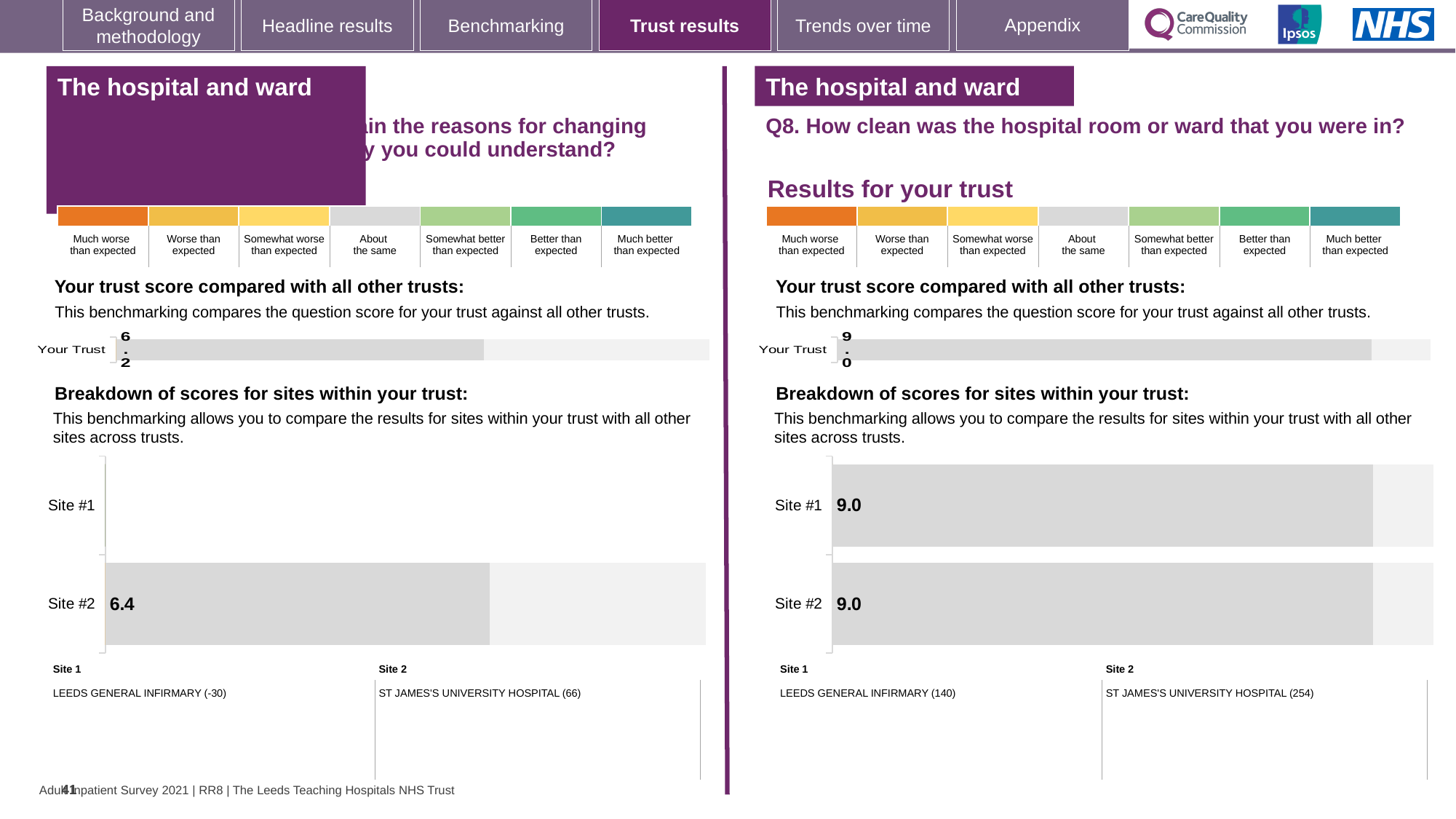
On the right half of the slide (Q8), what is the score for Site #2 in the breakdown of scores for sites? 9.0 On the left half of the slide, what is the score for Site #2 in the breakdown of scores for sites? 6.4 On the left half of the slide, what is the difference between the Site #2 score and the Your Trust score? 0.2 On the right half of the slide (Q8), what is the difference between the scores for Site #1 and Site #2? 0.0 On the right half of the slide (Q8), what is the score shown for Your Trust? 9.0 How many sites are listed in the breakdown of scores chart on the right half of the slide? 2 What kind of chart is used to show the breakdown of scores for sites on the right half of the slide? Bar chart On the left half of the slide, what is the score shown for Your Trust? 6.2 What is the question number and text shown at the top of the right half of the slide? Q8. How clean was the hospital room or ward that you were in? On the right half of the slide (Q8), what is the score for Site #1 in the breakdown of scores for sites? 9.0 On the left half of the slide, which is larger: the Your Trust score or the Site #2 score? Site #2 On the right half of the slide, which hospital is listed as Site 1? LEEDS GENERAL INFIRMARY